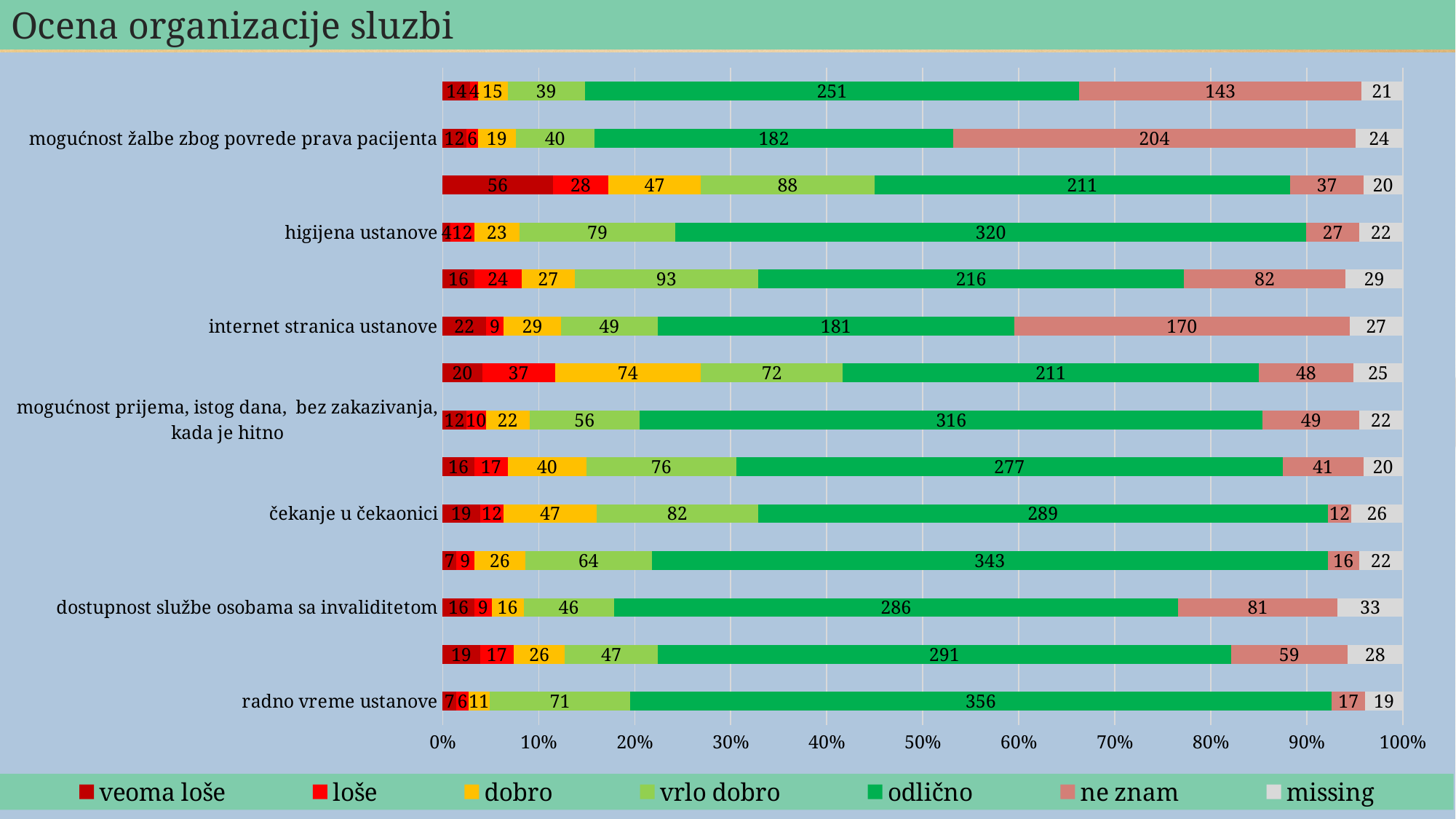
Which has the larger 'ne znam' value: 'internet stranica ustanove' or 'mogućnost žalbe zbog povrede prava pacijenta'? mogućnost žalbe zbog povrede prava pacijenta What is the 'dobro' value for 'čekanje u čekaonici'? 47 What is the 'ne znam' value for 'mogućnost žalbe zbog povrede prava pacijenta'? 204 What kind of chart is shown on the slide? Stacked bar chart What is the 'vrlo dobro' value for 'higijena ustanove'? 79 How many series does the legend list? 7 What is the difference between the 'odlično' values for 'radno vreme ustanove' and 'higijena ustanove'? 36 What is the 'odlično' value for 'radno vreme ustanove'? 356 What is the total of all segments in the bar for 'mogućnost prijema, istog dana, bez zakazivanja, kada je hitno'? 487 Among the labelled categories, which has the highest 'odlično' value? radno vreme ustanove What is the title of the chart? Ocena organizacije sluzbi What is the 'missing' value for 'dostupnost službe osobama sa invaliditetom'? 33